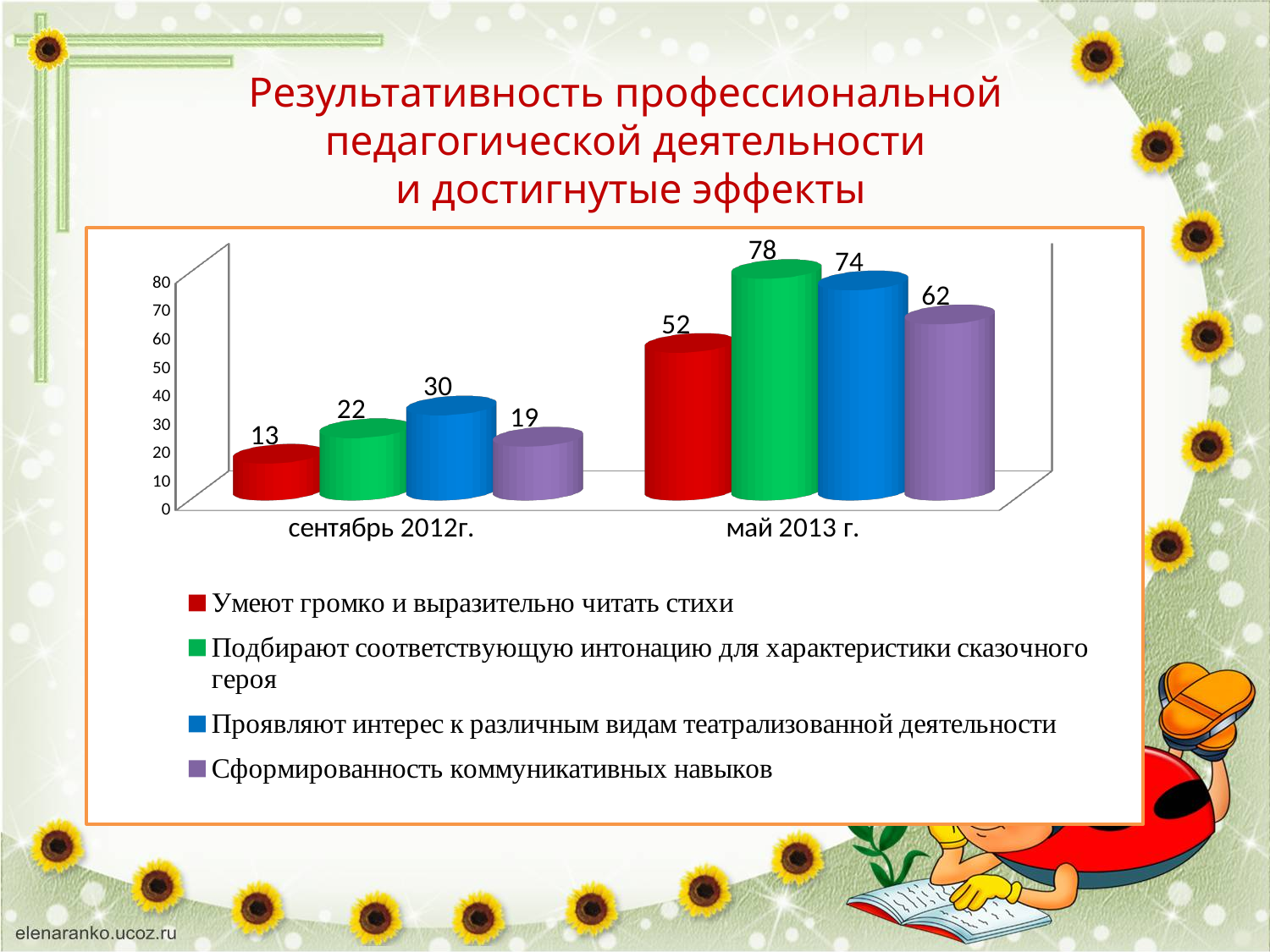
What colour represents "Сформированность коммуникативных навыков" in the chart? Purple What value is shown for "Умеют громко и выразительно читать стихи" in сентябрь 2012г.? 13 What kind of chart is shown on the slide? Bar chart How many series does the legend list? 4 Which series has the highest value in май 2013 г.? Подбирают соответствующую интонацию для характеристики сказочного героя Do the values for "Проявляют интерес к различным видам театрализованной деятельности" rise or fall from сентябрь 2012г. to май 2013 г.? Rise What value is shown for "Проявляют интерес к различным видам театрализованной деятельности" in май 2013 г.? 74 What is the difference between the май 2013 г. and сентябрь 2012г. values for "Подбирают соответствующую интонацию для характеристики сказочного героя"? 56 Which is larger in май 2013 г.: the value for "Умеют громко и выразительно читать стихи" or for "Сформированность коммуникативных навыков"? Сформированность коммуникативных навыков Which series has the lowest value in сентябрь 2012г.? Умеют громко и выразительно читать стихи How many categories are shown on the x axis? 2 What value is shown for "Сформированность коммуникативных навыков" in сентябрь 2012г.? 19